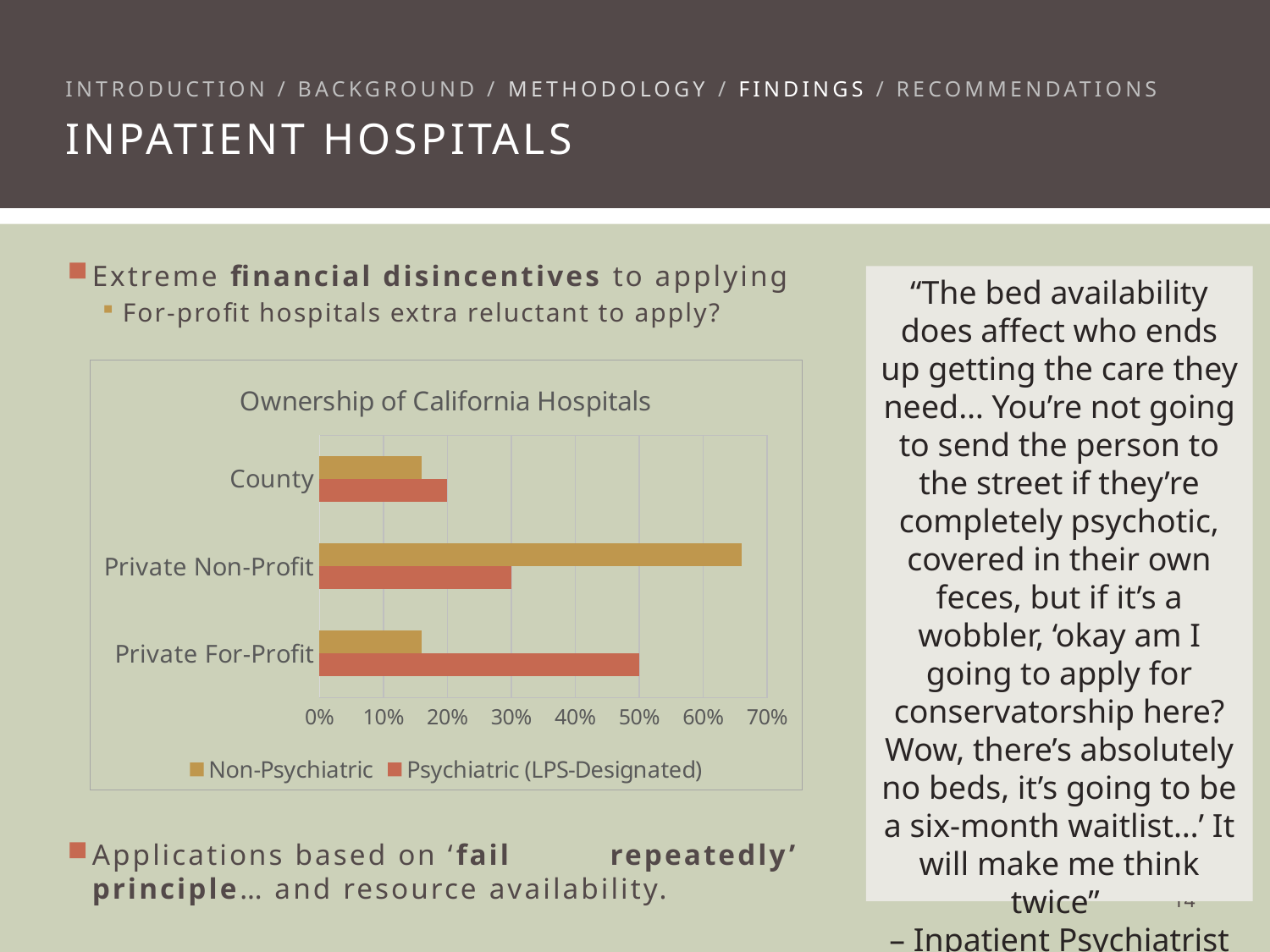
Is the Non-Psychiatric value for Private Non-Profit greater or less than 60%? greater How many ownership categories are shown on the chart? 3 For Private For-Profit, which is larger: the Non-Psychiatric value or the Psychiatric (LPS-Designated) value? Psychiatric (LPS-Designated) For Private Non-Profit, which is larger: the Non-Psychiatric value or the Psychiatric (LPS-Designated) value? Non-Psychiatric Which ownership category has the lowest Psychiatric (LPS-Designated) value? County What is the title of the chart? Ownership of California Hospitals How many series does the chart's legend list? 2 Which ownership category has the highest Psychiatric (LPS-Designated) value? Private For-Profit Is the Non-Psychiatric value for County greater or less than 20%? less What kind of chart is shown on the slide? Bar chart What are the two series named in the chart's legend? Non-Psychiatric and Psychiatric (LPS-Designated) Which ownership category has the highest Non-Psychiatric value? Private Non-Profit